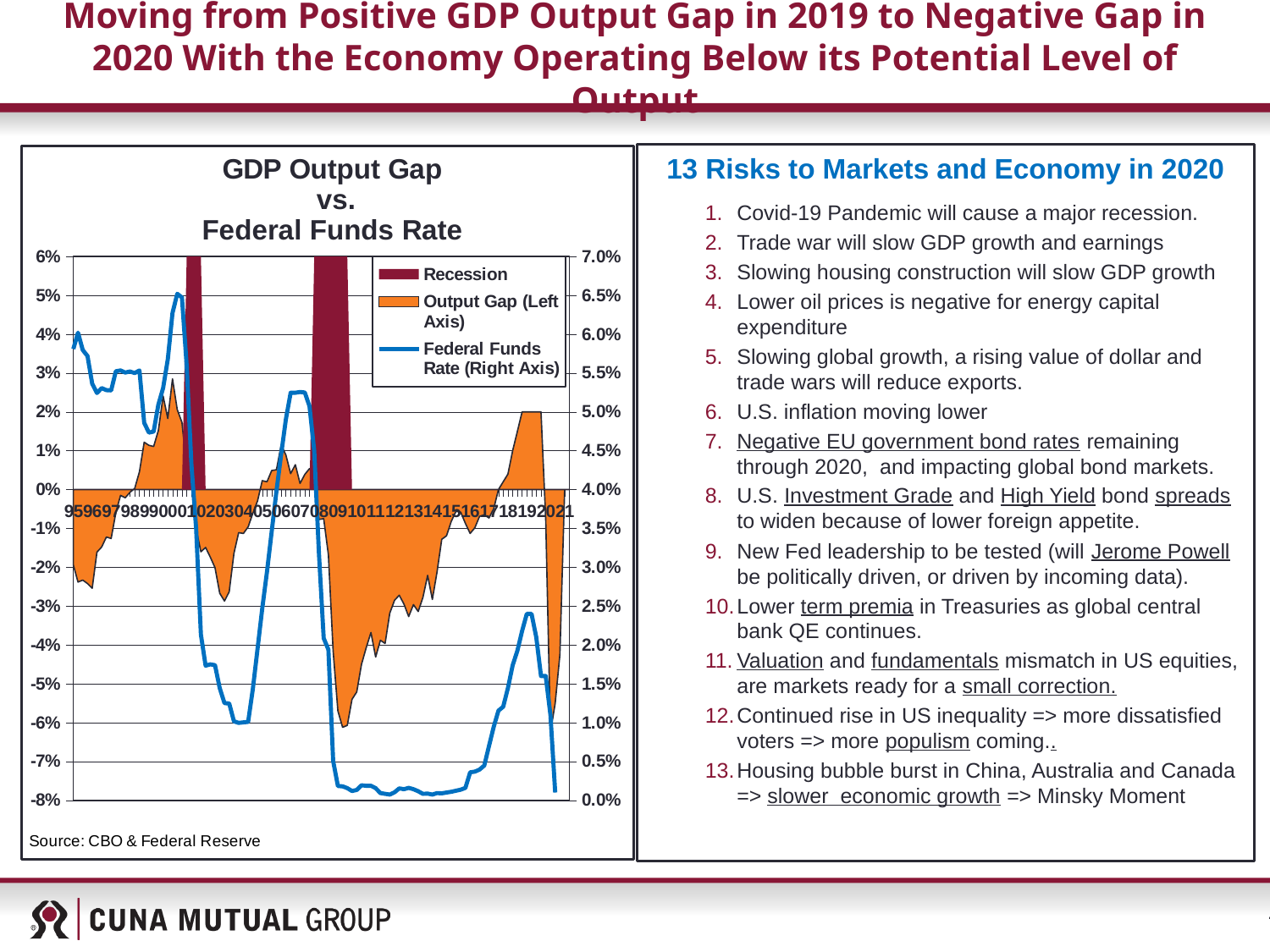
How many recession periods are shaded on the chart? 2 Is the Federal Funds Rate in 2000 greater or less than 5.5%? greater Does the Federal Funds Rate rise or fall from 2016 to 2019? rise How many series does the chart legend list? 3 What is the maximum value shown on the right axis of the chart? 7.0% Is the Output Gap in 2009 greater or less than -4%? less Is the Output Gap in 2019 greater or less than 0%? greater What is the title of the chart on the left of the slide? GDP Output Gap vs. Federal Funds Rate What kind of chart is the GDP Output Gap vs. Federal Funds Rate chart? Combination area and line chart Which series in the chart is plotted against the right axis? Federal Funds Rate